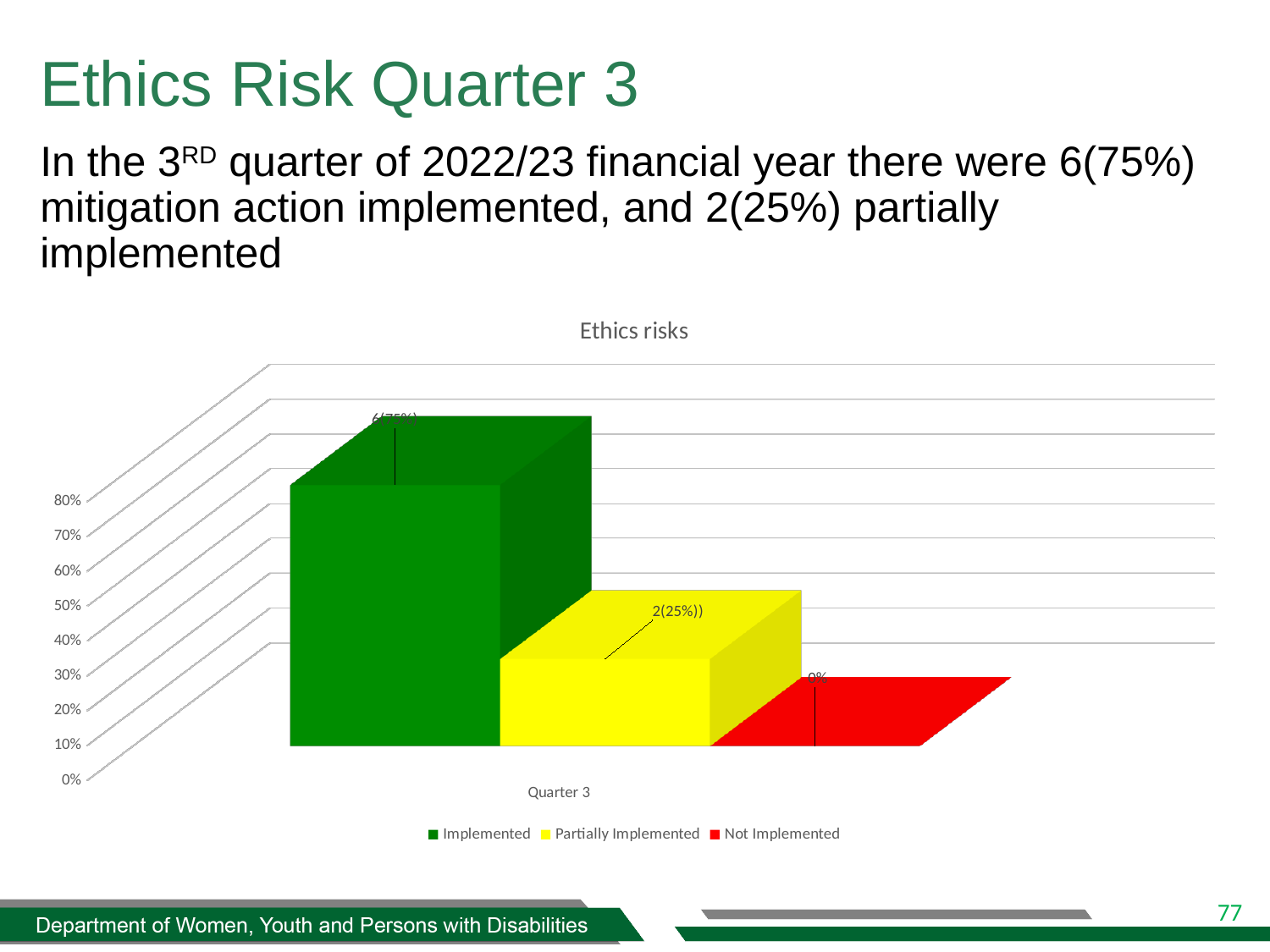
How many categories are shown on the x axis of the chart? 1 Which series has the highest value in Quarter 3? Implemented What percentage of mitigation actions were Implemented in Quarter 3? 75% What is the value shown for Not Implemented in Quarter 3? 0% Which series has the lowest value in Quarter 3? Not Implemented What kind of chart is shown on the slide? bar chart What percentage of mitigation actions were Partially Implemented in Quarter 3? 25% What is the title of the chart? Ethics risks Is the value for Implemented in Quarter 3 greater or less than 50%? greater What is the difference in percentage points between Implemented and Partially Implemented in Quarter 3? 50% Which colour represents the Not Implemented series in the chart? red How many series does the chart legend list? 3